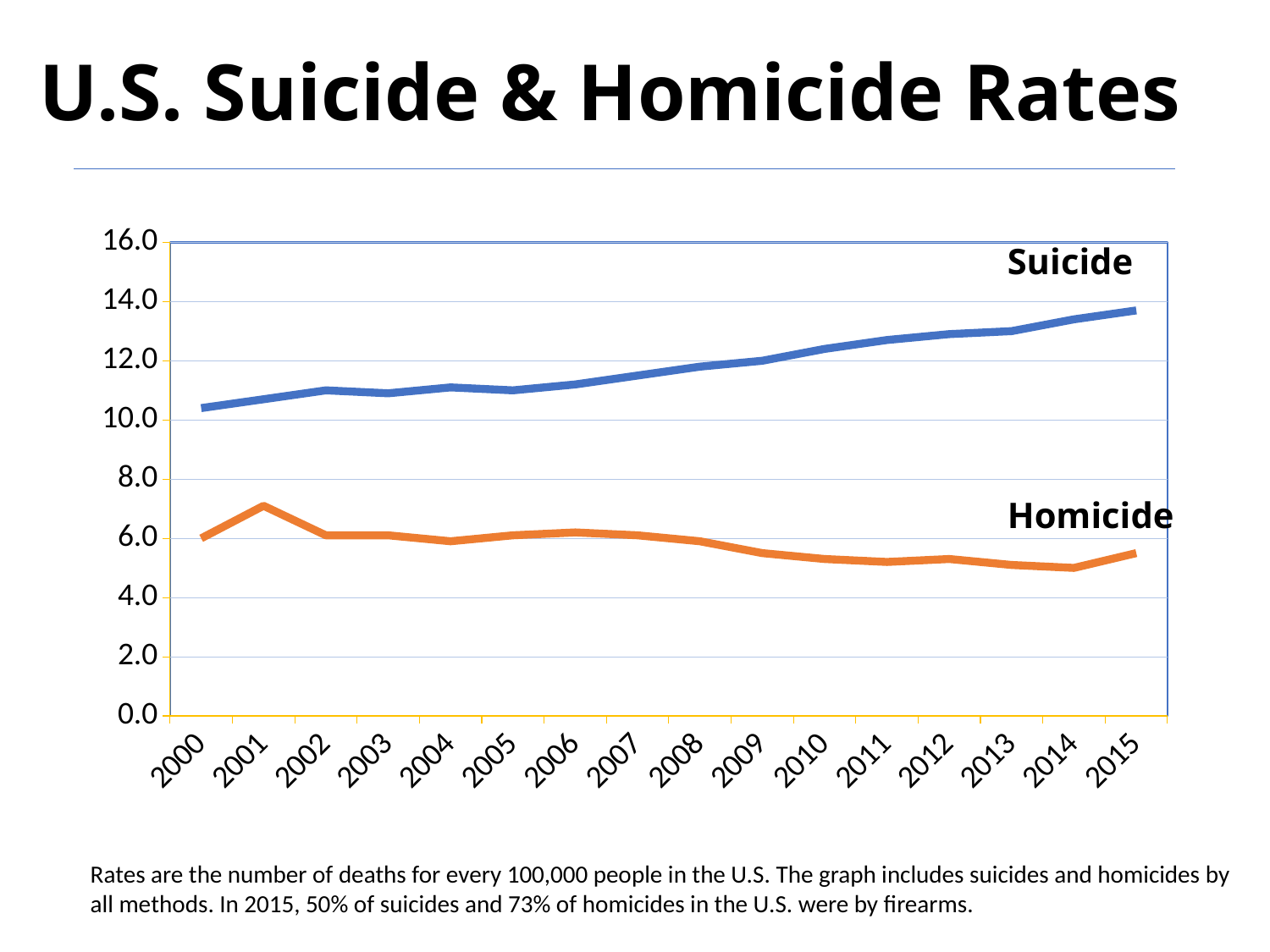
Is the Homicide rate in 2014 greater or less than 6.0? less In which year is the Suicide rate lowest? 2000 What kind of chart is shown on the slide? line chart Is the Suicide rate in 2015 greater or less than 12.0? greater How many years are plotted along the x axis? 16 Which two series are labelled on the chart? Suicide and Homicide In 2015, which series has the higher rate, Suicide or Homicide? Suicide Does the Suicide rate rise or fall from 2000 to 2015? rise Does the Homicide rate rise or fall overall from 2001 to 2014? fall In which year is the Homicide rate highest? 2001 In which year is the Suicide rate highest? 2015 How many series are plotted on the chart? 2